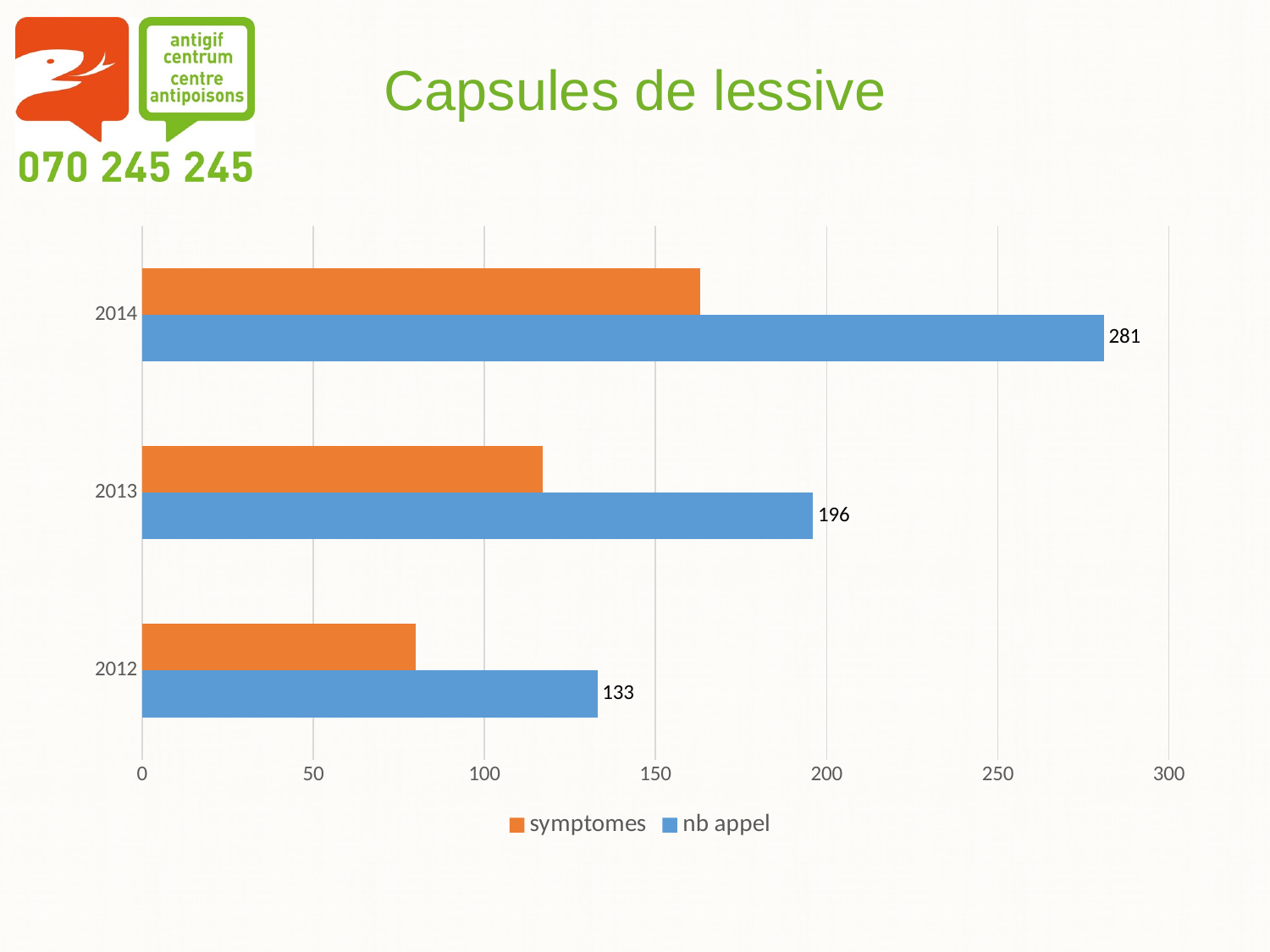
Do the nb appel values rise or fall from 2012 to 2014? rise Is the symptomes value for 2012 greater or less than 100? less What is the difference between the nb appel values for 2013 and 2012? 63 What is the value of nb appel for 2013? 196 Which year has the lowest nb appel value? 2012 Is the symptomes value for 2014 greater or less than 150? greater What kind of chart is shown on the slide? bar chart What is the value of nb appel for 2012? 133 What is the value of nb appel for 2014? 281 What is the difference between the nb appel values for 2014 and 2013? 85 How many series does the legend list? 2 Which year has the highest nb appel value? 2014